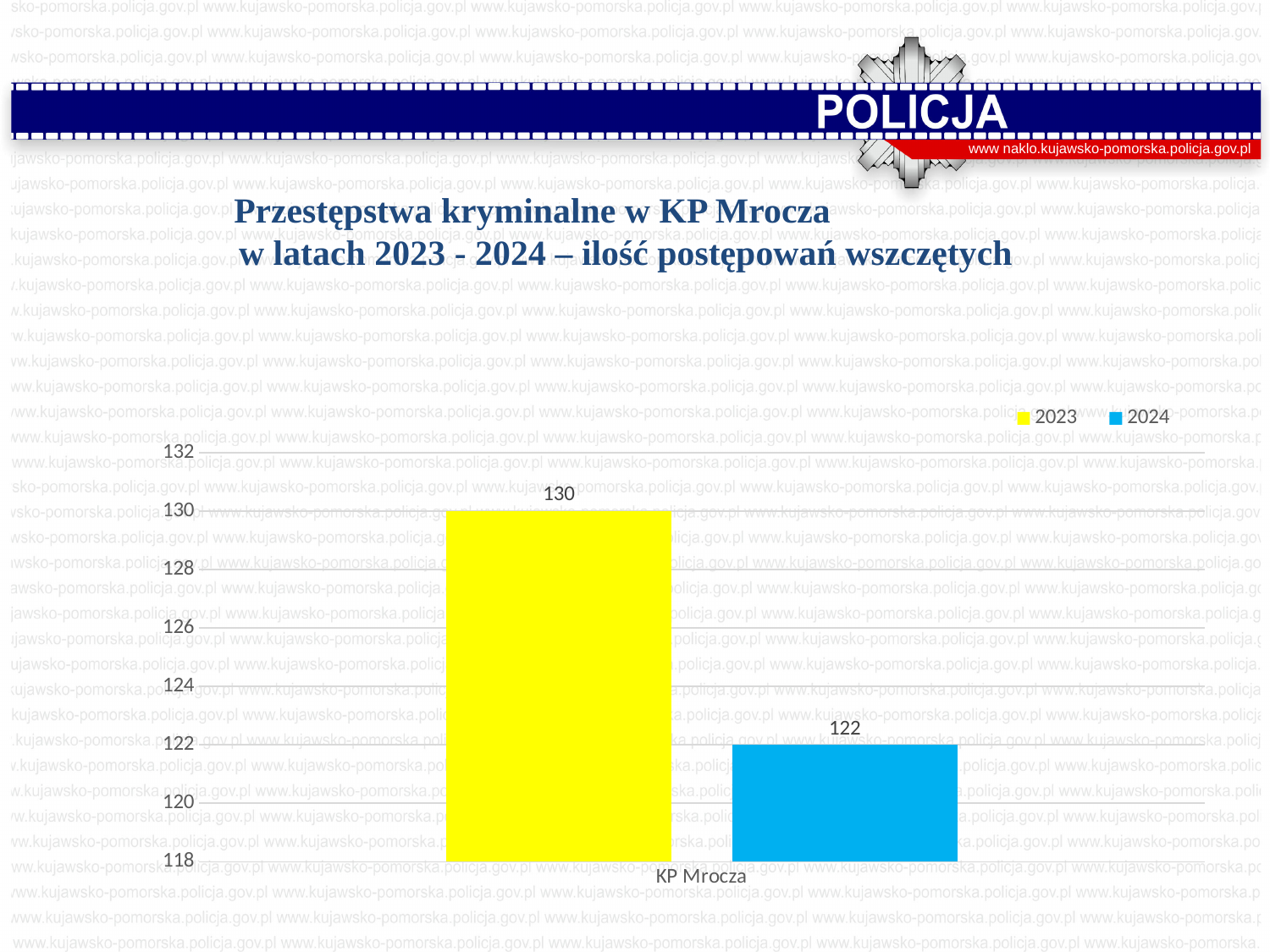
Which series has the higher value, 2023 or 2024? 2023 Which colour represents 2024 in the legend? blue What is the value for 2023 in the chart? 130 Is the value for 2024 greater or less than 124? less Which year has the lowest value in the chart? 2024 What is the value for 2024 in the chart? 122 What is the difference between the 2023 and 2024 values? 8 What is the category label on the x axis? KP Mrocza What kind of chart is shown on the slide? bar chart Is the value for 2023 greater or less than 128? greater How many series does the legend list? 2 How many categories are shown on the x axis? 1